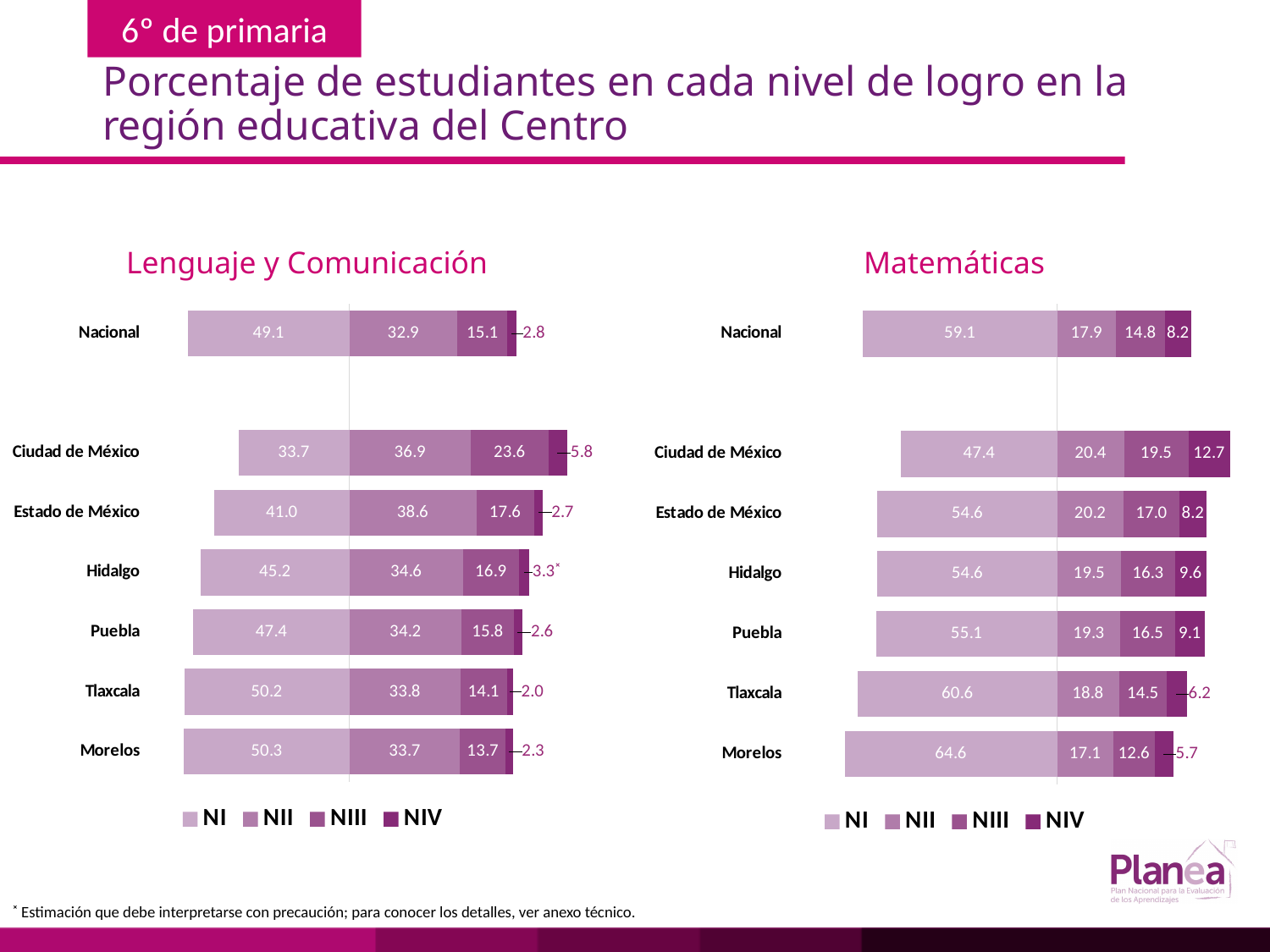
In the Matemáticas chart, what is the difference between the NIV value for Ciudad de México and the NIV value for Nacional? 4.5 In the Lenguaje y Comunicación chart, what is the NI value for Ciudad de México? 33.7 How many series does the legend of the Lenguaje y Comunicación chart list? 4 In the Matemáticas chart, what is the NIV value for Ciudad de México? 12.7 In the Matemáticas chart, which category has the highest NI value? Morelos In the Lenguaje y Comunicación chart, what is the total of the stacked bar for Nacional? 99.9 How many categories (rows) are shown in the Matemáticas chart? 7 What kind of chart is the Matemáticas chart? Stacked bar chart In the Matemáticas chart, what is the NII value for Puebla? 19.3 In the Lenguaje y Comunicación chart, which category has the lowest NI value? Ciudad de México In the Lenguaje y Comunicación chart, which is larger: the NIII value for Ciudad de México or the NIII value for Morelos? Ciudad de México What are the legend entries of the Matemáticas chart? NI, NII, NIII, NIV